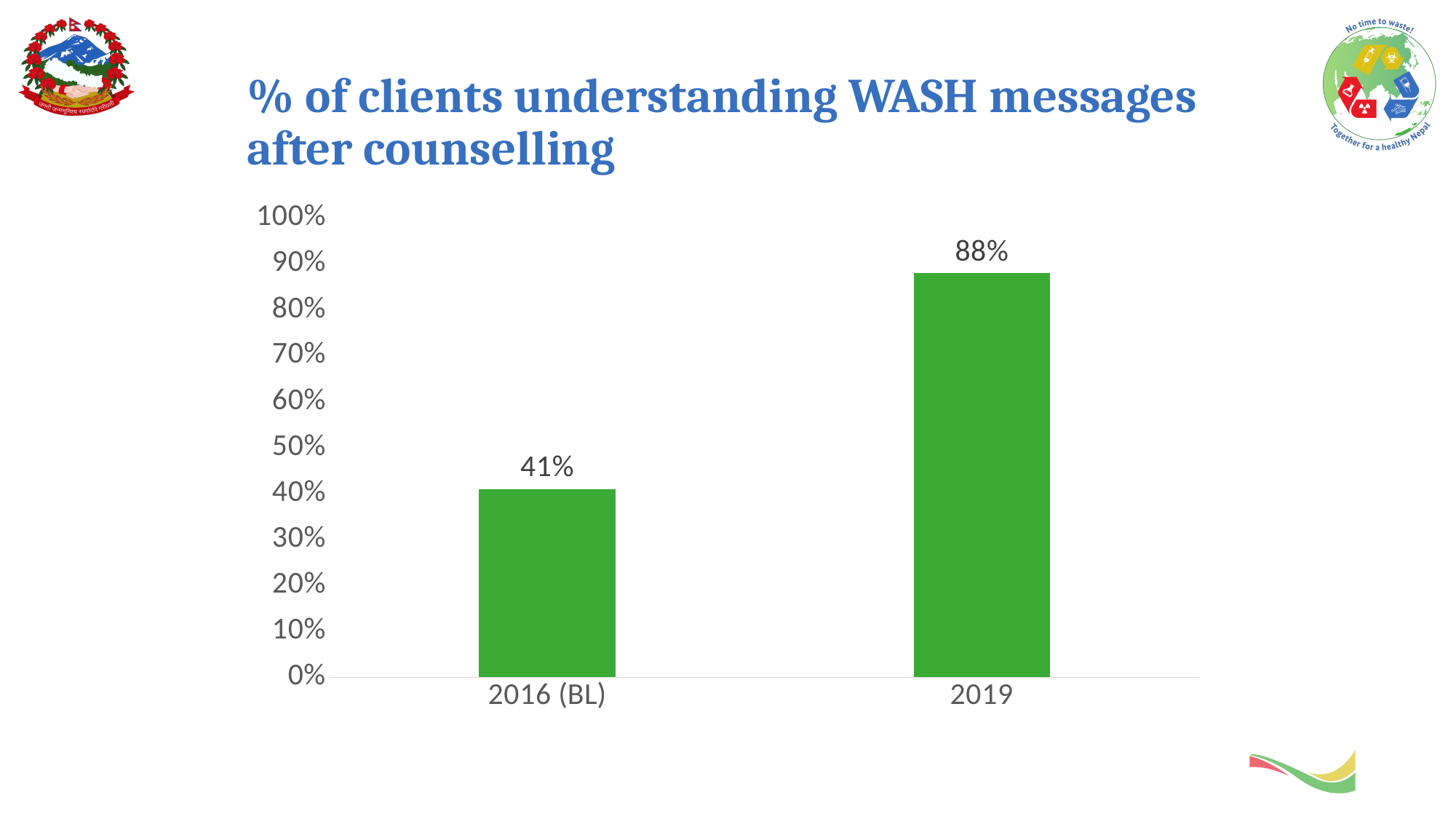
Is the value for 2016 (BL) greater or less than 50%? less Do the values rise or fall from 2016 (BL) to 2019? rise Which is larger, the value for 2016 (BL) or the value for 2019? 2019 What is the value for 2016 (BL)? 41% What is the difference between the values for 2019 and 2016 (BL)? 47% Which category has the lowest value? 2016 (BL) What kind of chart is shown on the slide? bar chart Is the value for 2019 greater or less than 80%? greater Which category has the highest value? 2019 What is the title of the chart? % of clients understanding WASH messages after counselling How many categories are shown on the x axis? 2 What is the value for 2019? 88%